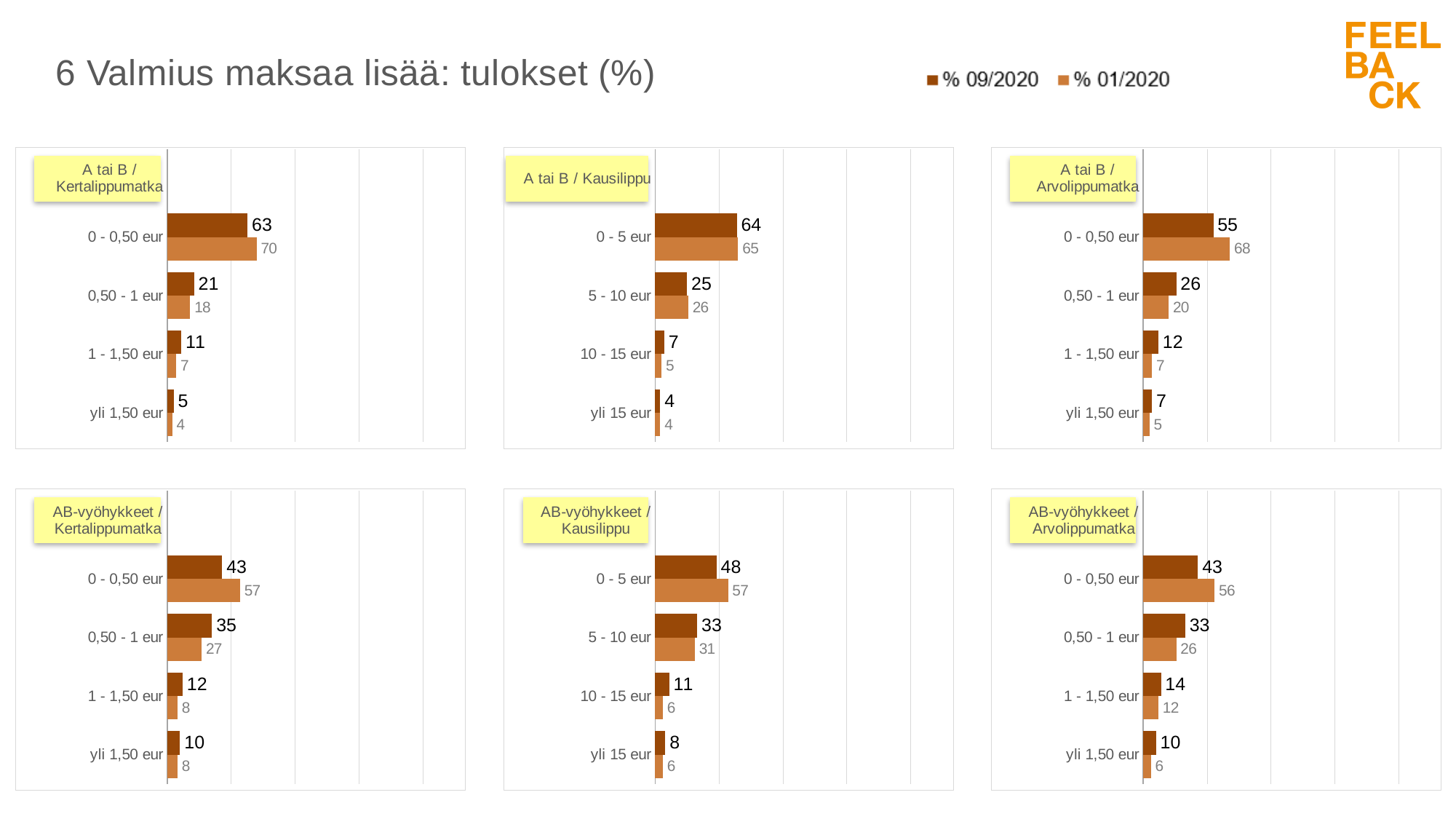
How many series does the legend list? 2 In the 'A tai B / Kertalippumatka' chart, what is the value for '0 - 0,50 eur' in the % 09/2020 series? 63 In the 'A tai B / Arvolippumatka' chart, what is the difference between the % 01/2020 and % 09/2020 values for '0 - 0,50 eur'? 13 How many categories does the 'A tai B / Kausilippu' chart show? 4 What kind of chart is the 'AB-vyöhykkeet / Kausilippu' chart? Bar chart In the 'A tai B / Arvolippumatka' chart, which category has the highest % 09/2020 value? 0 - 0,50 eur In the 'AB-vyöhykkeet / Arvolippumatka' chart, what is the value for '1 - 1,50 eur' in the % 01/2020 series? 12 How many charts are shown on the slide? 6 In the 'AB-vyöhykkeet / Kertalippumatka' chart, which series has the larger value for '0,50 - 1 eur', % 09/2020 or % 01/2020? % 09/2020 In the 'A tai B / Kausilippu' chart, what is the value for '5 - 10 eur' in the % 01/2020 series? 26 In the 'AB-vyöhykkeet / Kertalippumatka' chart, what is the difference between the % 01/2020 and % 09/2020 values for '0 - 0,50 eur'? 14 In the 'AB-vyöhykkeet / Kausilippu' chart, which category has the lowest % 01/2020 value? 10 - 15 eur and yli 15 eur (both 6)